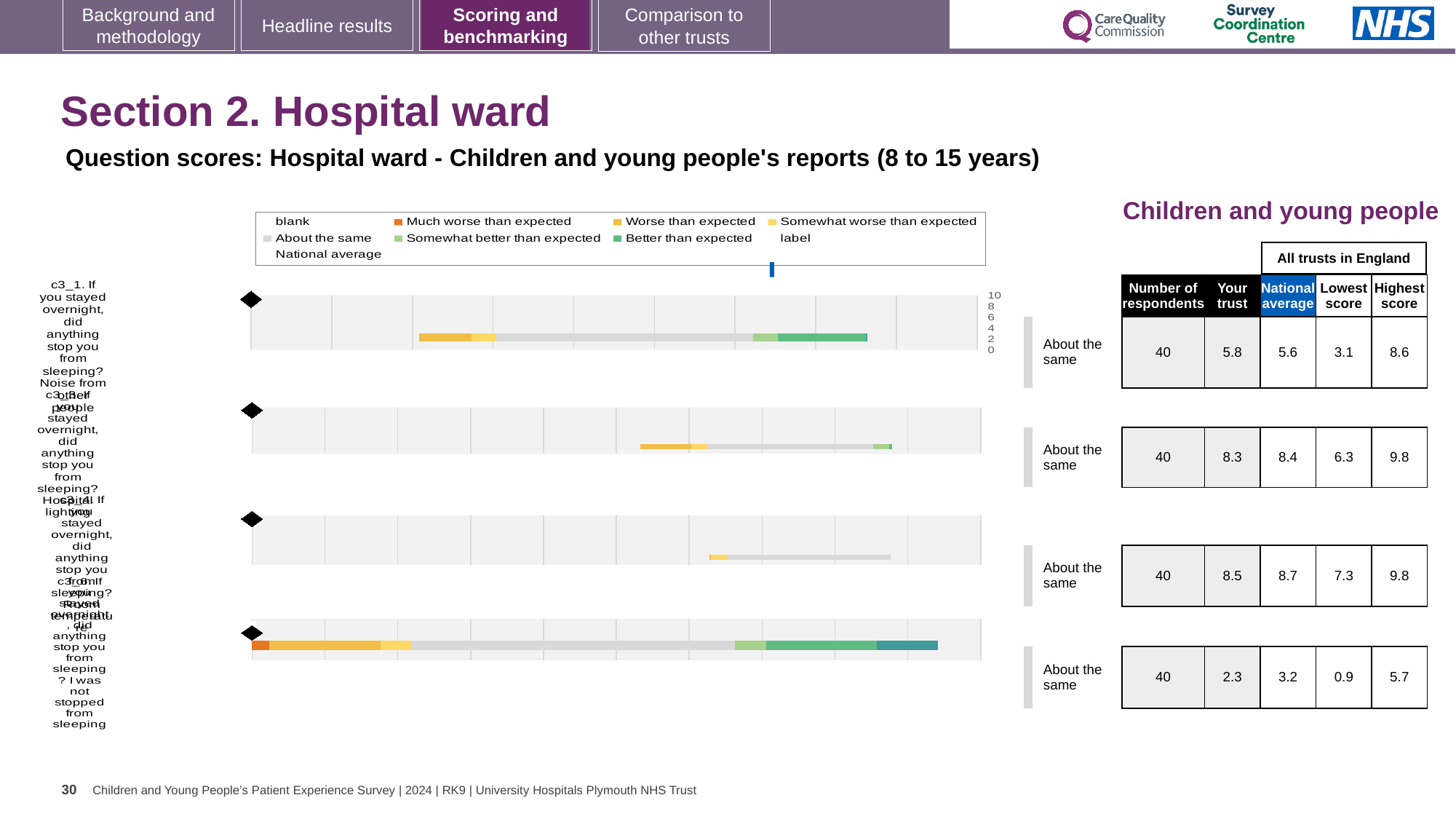
In the table beside the chart, what is the national average for the fourth row (c3_6)? 3.2 For the second row, what is the difference between the highest score (9.8) and the lowest score (6.3) in the table? 3.5 Which row has the highest 'Your trust' score in the table beside the chart? the third row (8.5) For the first row (c3_1), which is larger: the 'Your trust' score or the national average? Your trust (5.8) What is the highest tick value shown on the chart's axis? 10 What colour does the legend use for 'Much worse than expected'? orange In the table beside the chart, how many respondents are listed for the first row? 40 How many question rows (bars) does the chart show? 4 What kind of chart is shown on the slide? bar chart In the table beside the chart, what is the 'Your trust' score for the first row (c3_1, noise from other people)? 5.8 What benchmark category is shown next to each of the four rows? About the same How many entries does the chart's legend list? 9